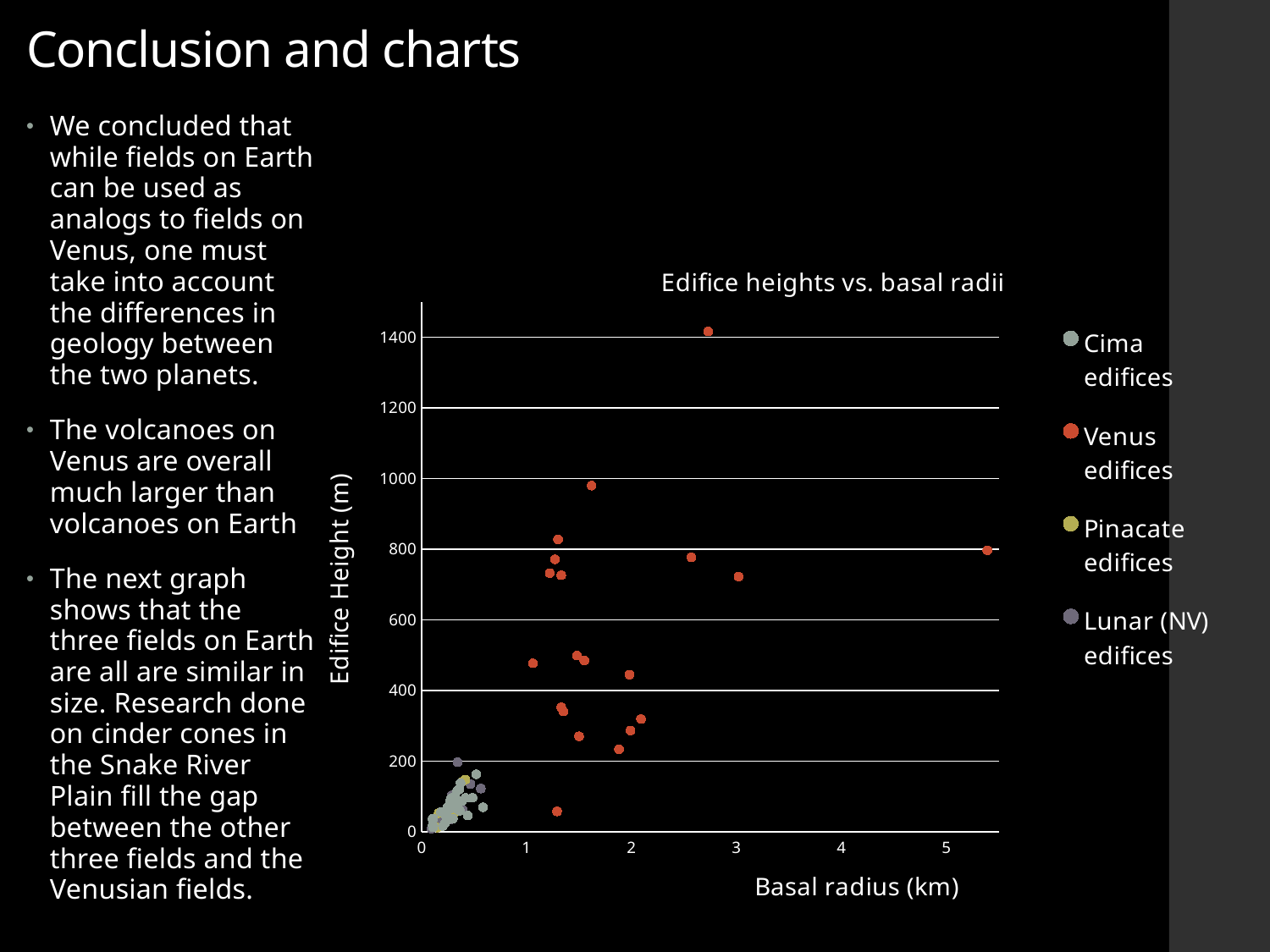
What is the highest value labelled on the vertical axis of the chart? 1400 What kind of chart is shown on the slide? scatter chart Which series in the legend is shown with red markers? Venus edifices How many series does the legend of the chart list? 4 Is the edifice height of the highest Venus edifices point greater or less than 1200? greater Is the basal radius of the highest Venus edifices point greater or less than 2 km? greater Which series contains the point with the greatest edifice height? Venus edifices Which series contains the point with the largest basal radius? Venus edifices What is the title of the chart? Edifice heights vs. basal radii Is the edifice height of the Venus edifices point with the largest basal radius (beyond 5 km) greater or less than 600? greater Which series has points with larger edifice heights overall: Venus edifices or Cima edifices? Venus edifices